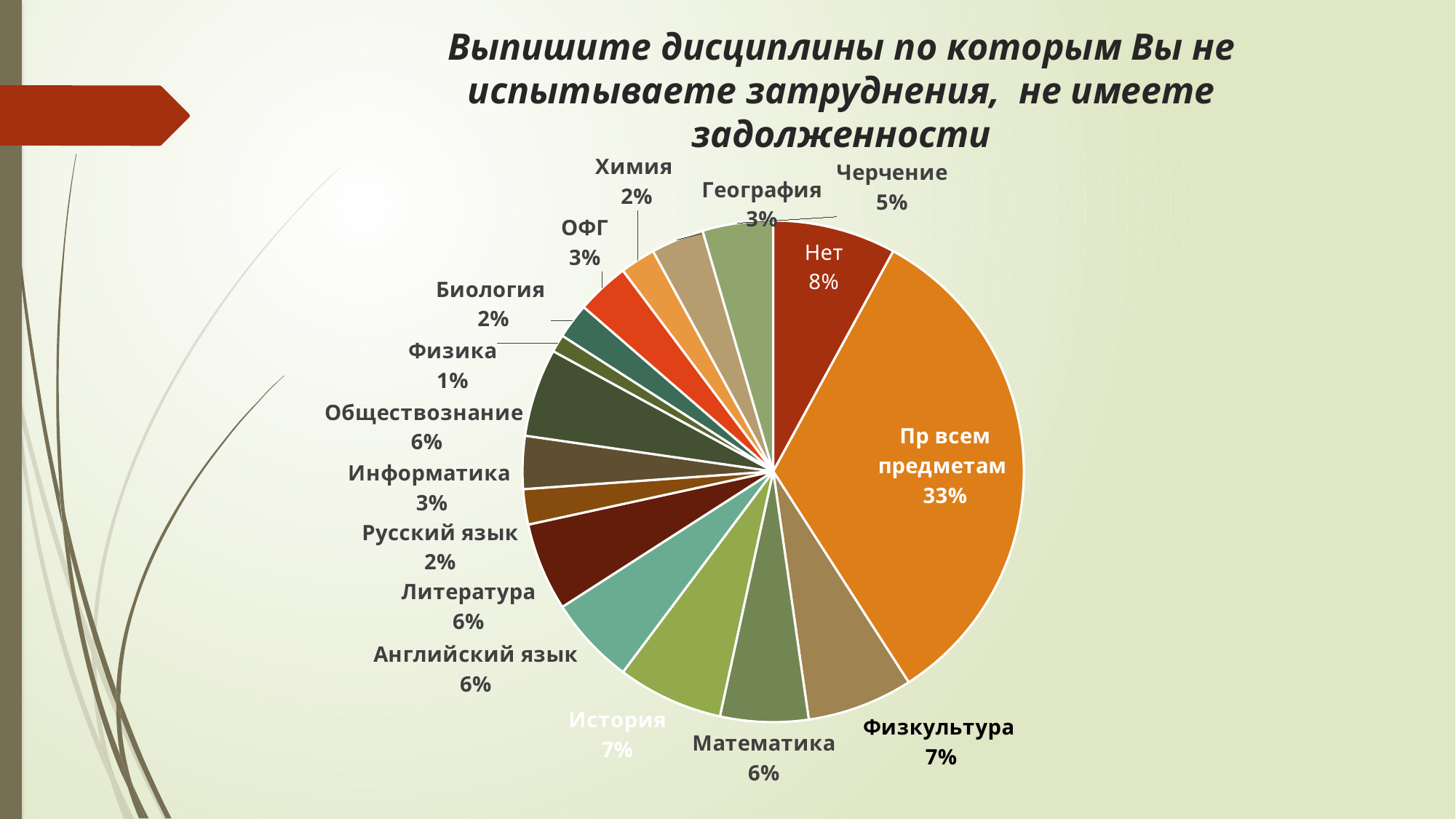
What is the value shown for "Черчение"? 5% Which category has the smallest slice of the pie? Физика What is the value shown for "Физика"? 1% What kind of chart is shown on the slide? pie chart What share of the pie does "Пр всем предметам" have? 33% What is the difference between the values for "Пр всем предметам" and "Нет"? 25% How many slices does the pie chart have? 16 Which category has the largest slice of the pie? Пр всем предметам Which is larger, the value for "История" or the value for "Математика"? История What is the difference between the values for "Физкультура" and "Русский язык"? 5% What is the value shown for "Нет"? 8% What is the value shown for "Обществознание"? 6%